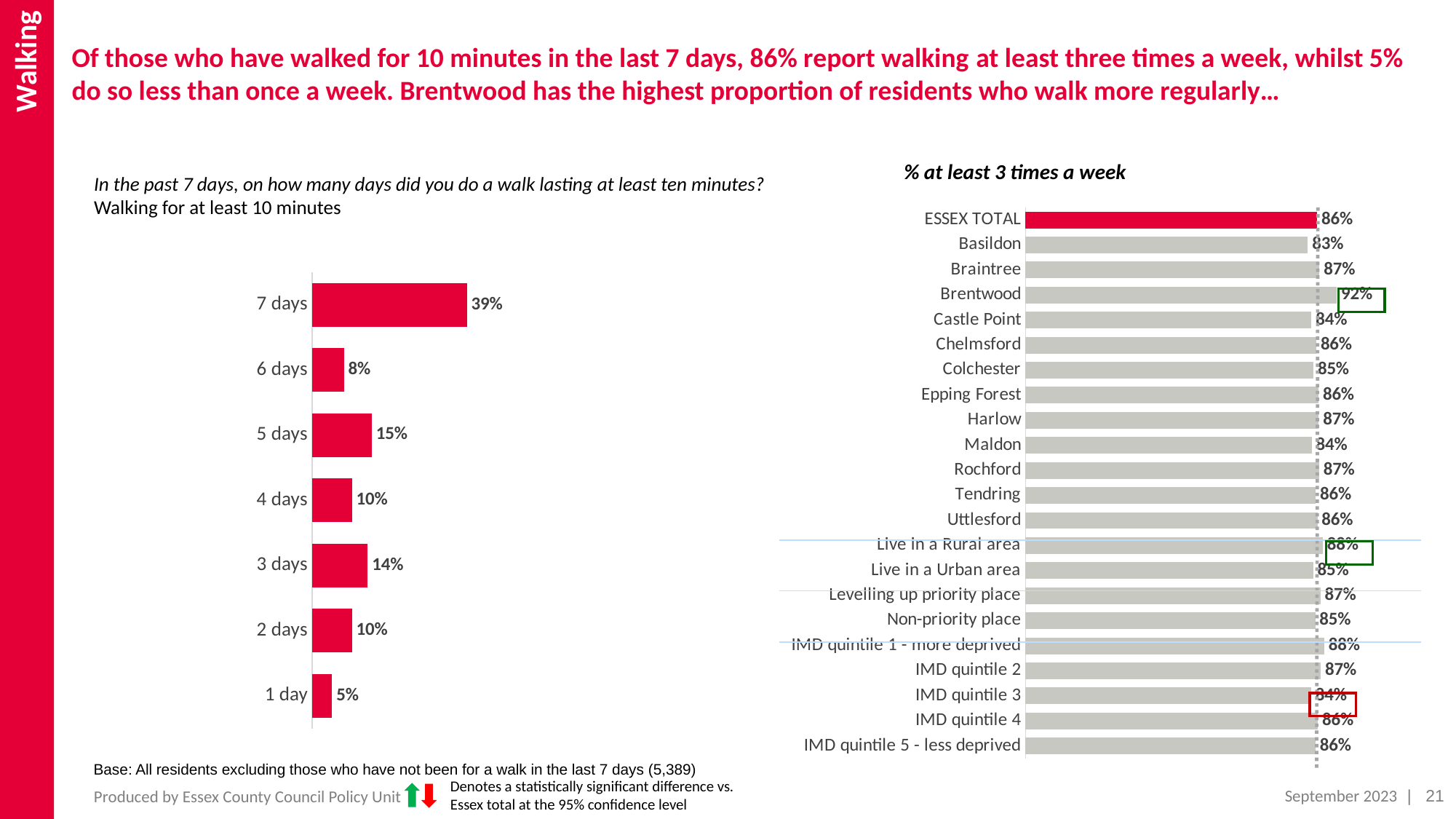
How many categories are shown in the 'Walking for at least 10 minutes' chart? 7 What type of chart is the 'Walking for at least 10 minutes' chart? Bar chart In the 'Walking for at least 10 minutes' chart, which is larger, the value for 6 days or the value for 4 days? 4 days In the '% at least 3 times a week' chart, which district has the highest value? Brentwood In the 'Walking for at least 10 minutes' chart, which category has the lowest value? 1 day In the 'Walking for at least 10 minutes' chart, what is the difference between the values for 7 days and 5 days? 24 percentage points In the '% at least 3 times a week' chart, which bar is coloured red rather than grey? ESSEX TOTAL In the '% at least 3 times a week' chart, what is the value for ESSEX TOTAL? 86% In the '% at least 3 times a week' chart, what is the value for Brentwood? 92% In the 'Walking for at least 10 minutes' chart, what percentage of respondents walked on 7 days? 39% In the '% at least 3 times a week' chart, what is the difference between Brentwood and Basildon? 9 percentage points In the 'Walking for at least 10 minutes' chart, what is the value for 3 days? 14%